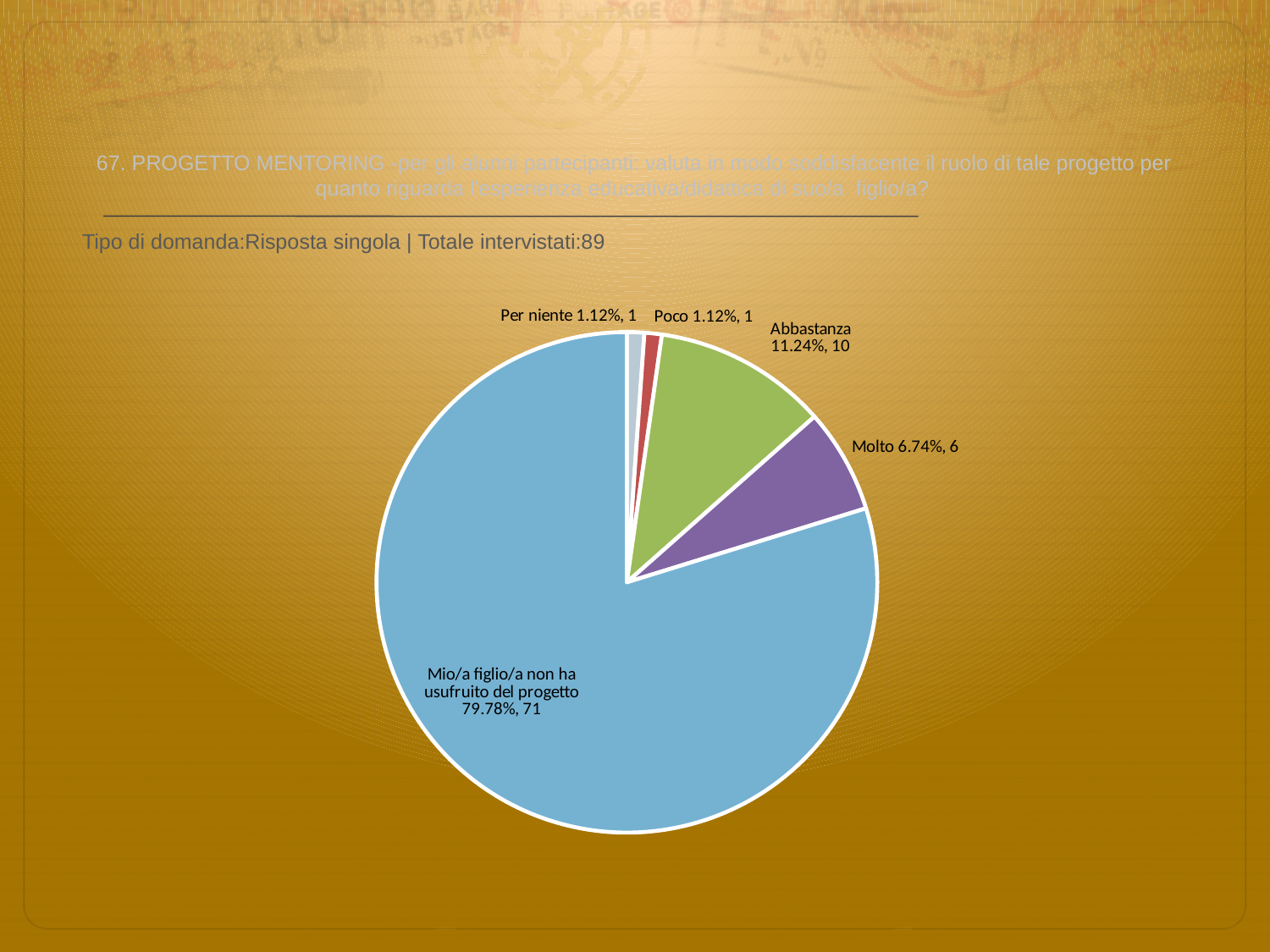
What is the difference between the number of respondents for "Mio/a figlio/a non ha usufruito del progetto" and for "Abbastanza"? 61 What percentage share does the "Abbastanza" slice have? 11.24% What is the total number of respondents (Totale intervistati) stated on the slide? 89 What is the difference between the number of respondents for "Abbastanza" and for "Molto"? 4 What colour is the "Abbastanza" slice? green What percentage share does the "Mio/a figlio/a non ha usufruito del progetto" slice have? 79.78% How many respondents chose "Molto"? 6 What kind of chart is shown on the slide? pie chart How many respondents chose "Poco"? 1 Which category has the largest slice of the pie? Mio/a figlio/a non ha usufruito del progetto How many slices does the pie chart have? 5 Which is larger, the count for "Abbastanza" or the count for "Molto"? Abbastanza